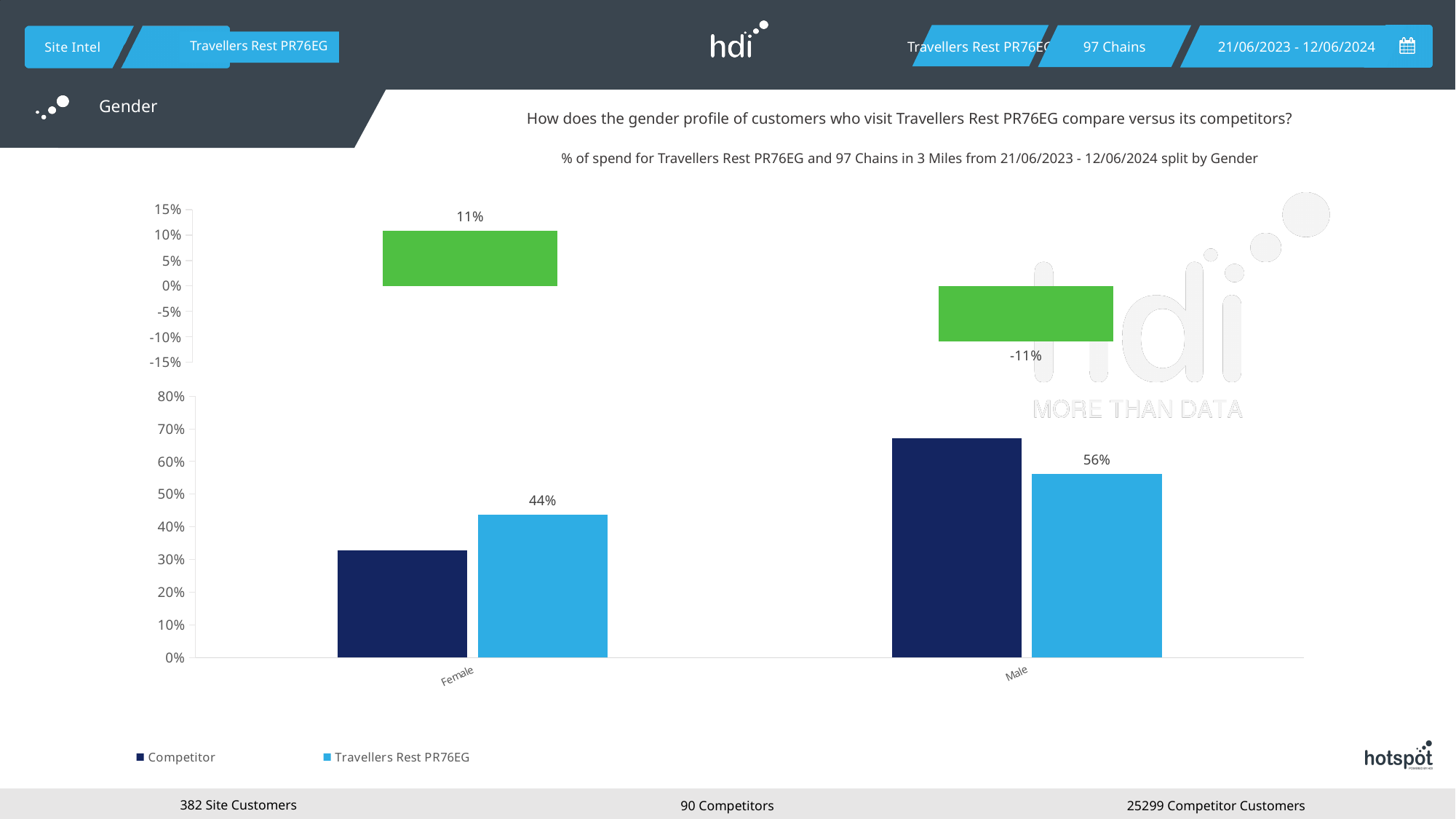
How many series does the legend of the bottom bar chart list? 2 In the bottom bar chart, which gender has the higher value for Travellers Rest PR76EG? Male What type of chart is the bottom chart on the slide? Bar chart In the top difference chart, what is the value shown for Female? 11% In the bottom bar chart, is the Competitor value for Male greater or less than 60%? greater In the bottom bar chart, what is the value for Travellers Rest PR76EG for Male? 56% In the bottom bar chart, what is the value for Travellers Rest PR76EG for Female? 44% In the bottom bar chart, for Female, which is larger: the Competitor bar or the Travellers Rest PR76EG bar? Travellers Rest PR76EG In the top difference chart, what is the value shown for Male? -11% In the bottom bar chart, what is the difference between the Travellers Rest PR76EG values for Male and Female? 12% In the bottom bar chart, for Male, which is larger: the Competitor bar or the Travellers Rest PR76EG bar? Competitor In the bottom bar chart, is the Competitor value for Female greater or less than 40%? less